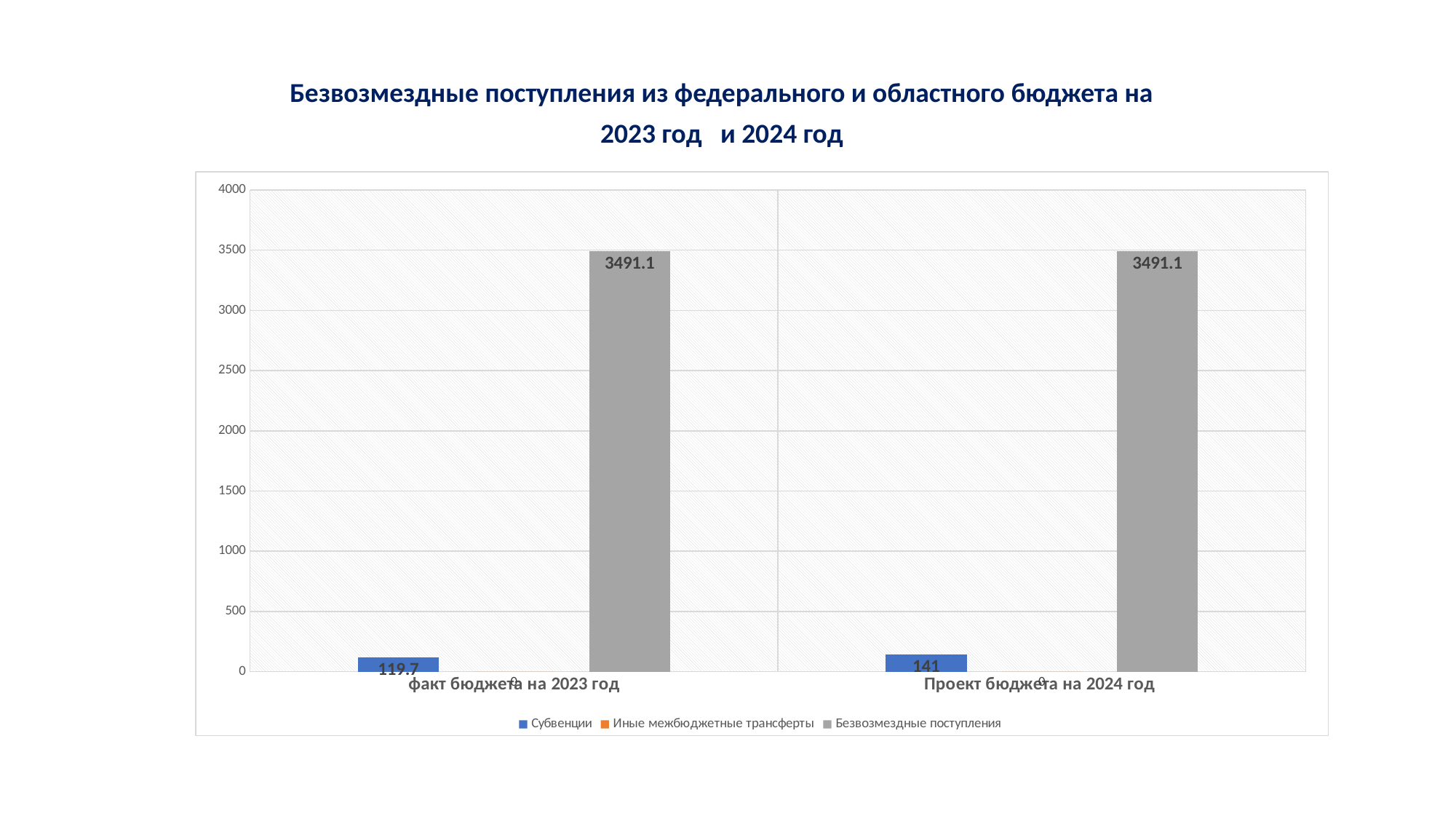
Is the value of Безвозмездные поступления for факт бюджета на 2023 год greater or less than 3000? greater How many series does the legend list? 3 How many categories are shown on the x axis? 2 What is the value of Субвенции for факт бюджета на 2023 год? 119.7 Which series has the highest value for Проект бюджета на 2024 год? Безвозмездные поступления Which series has the lowest value for факт бюджета на 2023 год? Иные межбюджетные трансферты Which is larger: Субвенции for факт бюджета на 2023 год or Субвенции for Проект бюджета на 2024 год? Проект бюджета на 2024 год What is the difference between the Субвенции values for Проект бюджета на 2024 год and факт бюджета на 2023 год? 21.3 What kind of chart is shown on the slide? bar chart What is the value of Субвенции for Проект бюджета на 2024 год? 141 What is the value of Безвозмездные поступления for Проект бюджета на 2024 год? 3491.1 What is the value of Безвозмездные поступления for факт бюджета на 2023 год? 3491.1